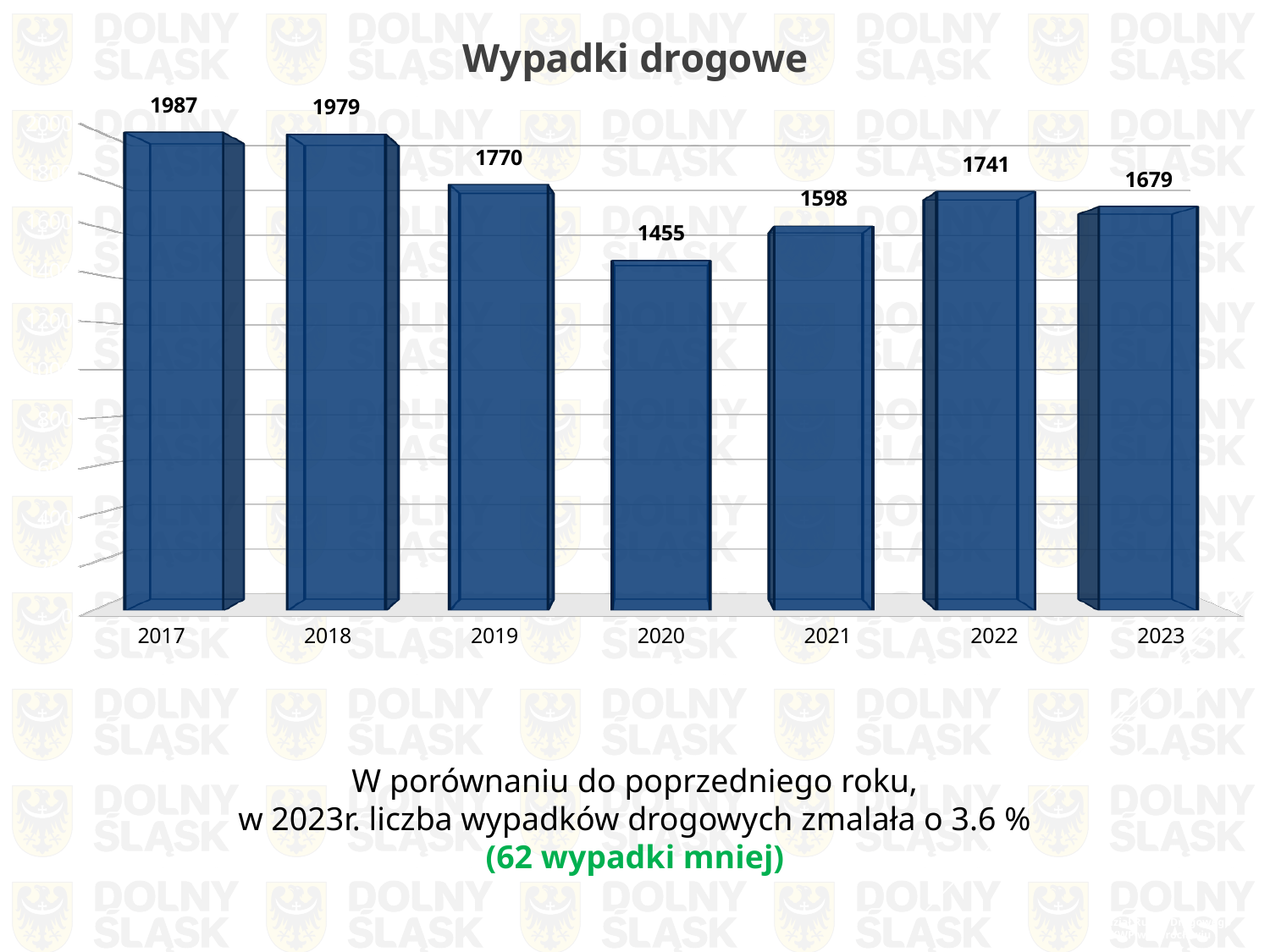
What is the difference between the values for 2022 and 2023? 62 How many years are shown on the x axis? 7 What is the value for 2020? 1455 Which year has the highest value? 2017 What is the value for 2023? 1679 Which year has the lowest value? 2020 What kind of chart is this? bar chart What is the difference between the values for 2017 and 2020? 532 Do the values rise or fall from 2017 to 2020? fall What is the value for 2017? 1987 Which is larger, the value for 2019 or the value for 2021? 2019 What is the title of the chart? Wypadki drogowe